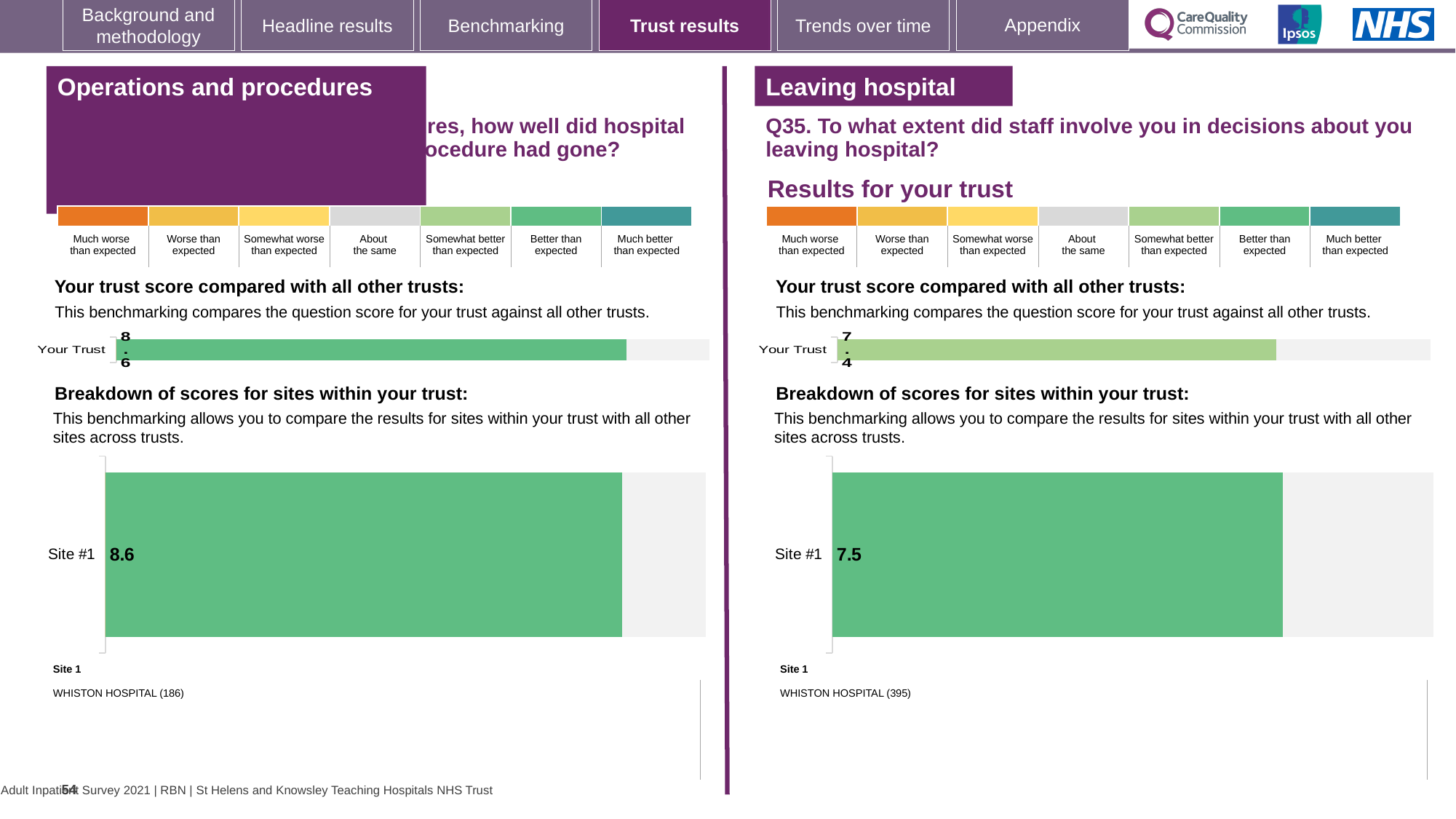
How many sites are shown in the left-hand 'Breakdown of scores for sites within your trust' chart? 1 On the right-hand 'Leaving hospital' section (Q35), what is the 'Your Trust' score shown in the trust comparison bar chart? 7.4 Which hospital is listed as Site 1 beneath the site breakdown charts? WHISTON HOSPITAL What is the difference between the Site #1 score in the left-hand chart (8.6) and the Site #1 score in the right-hand chart (7.5)? 1.1 In the right-hand 'Breakdown of scores for sites within your trust' chart (Q35), what is the score for Site #1? 7.5 In the left-hand 'Breakdown of scores for sites within your trust' chart, what is the score for Site #1? 8.6 What type of chart is used to show the Site #1 score in the right-hand 'Leaving hospital' section? Bar chart According to the colour key, which benchmark category does the colour of the right-hand 'Your Trust' bar (Q35) correspond to? Somewhat better than expected On the left-hand 'Operations and procedures' section, what is the 'Your Trust' score shown in the trust comparison bar chart? 8.6 What is the difference between the 'Your Trust' score on the left (8.6) and the 'Your Trust' score on the right (7.4)? 1.2 Which section shows the higher Site #1 score: 'Operations and procedures' on the left or 'Leaving hospital' on the right? Operations and procedures (left)